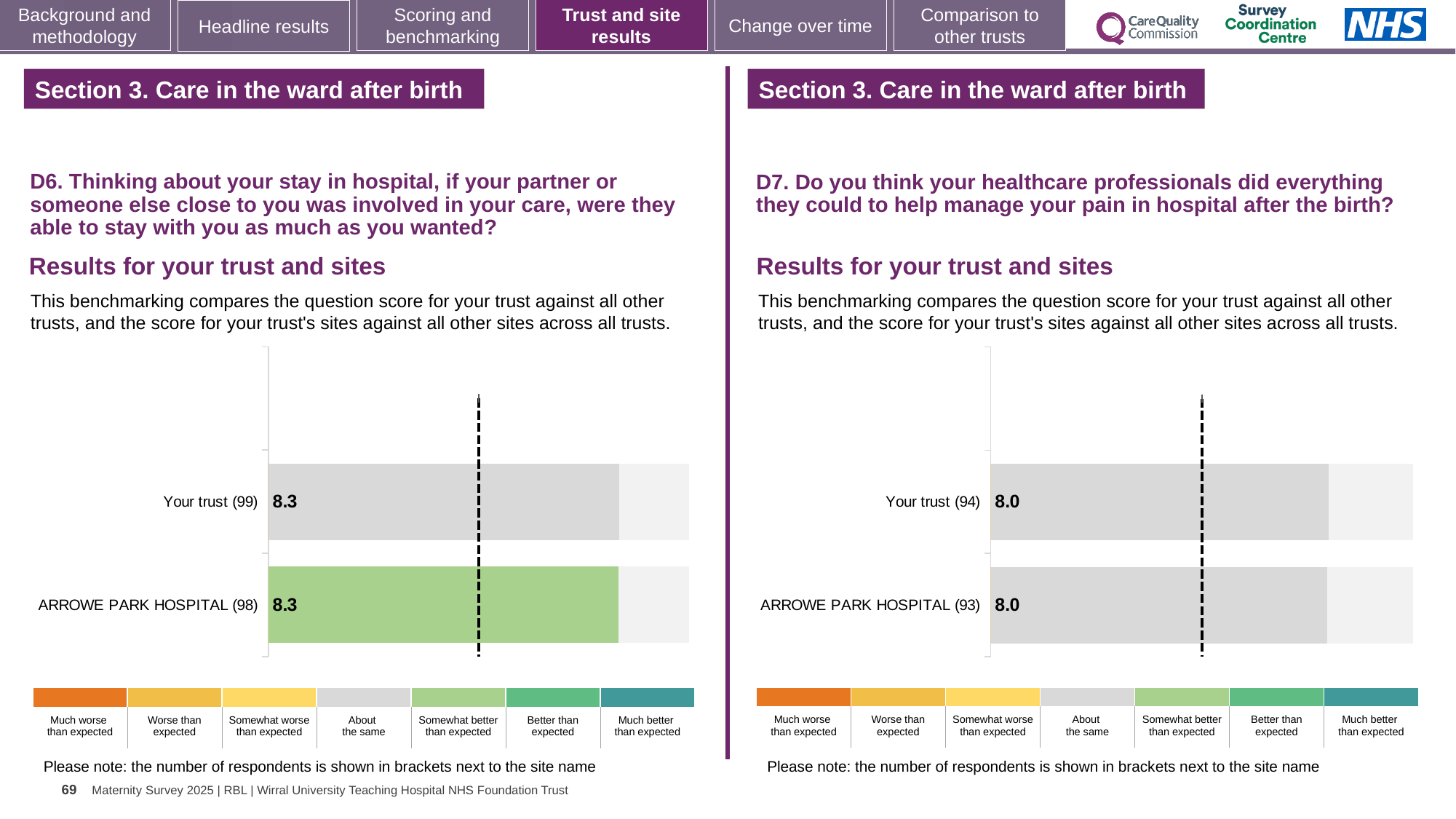
What kind of chart is the D6 chart on the left? Bar chart In the D6 chart on the left, what is the score for ARROWE PARK HOSPITAL? 8.3 In the D7 chart on the right, what is the difference between the score for Your trust and the score for ARROWE PARK HOSPITAL? 0.0 In the D7 chart on the right, what is the score for Your trust? 8.0 In the D6 chart on the left, is the score for Your trust greater or less than the score for ARROWE PARK HOSPITAL, or are they equal? Equal How many bars are plotted in the D6 chart on the left? 2 In the D6 chart on the left, what is the score for Your trust? 8.3 In the D6 chart on the left, how many respondents are shown in brackets for ARROWE PARK HOSPITAL? 98 In the D7 chart on the right, how many respondents are shown in brackets for Your trust? 94 How many bars are plotted in the D7 chart on the right? 2 In the D7 chart on the right, what is the score for ARROWE PARK HOSPITAL? 8.0 In the D6 chart on the left, what is the difference between the score for Your trust and the score for ARROWE PARK HOSPITAL? 0.0